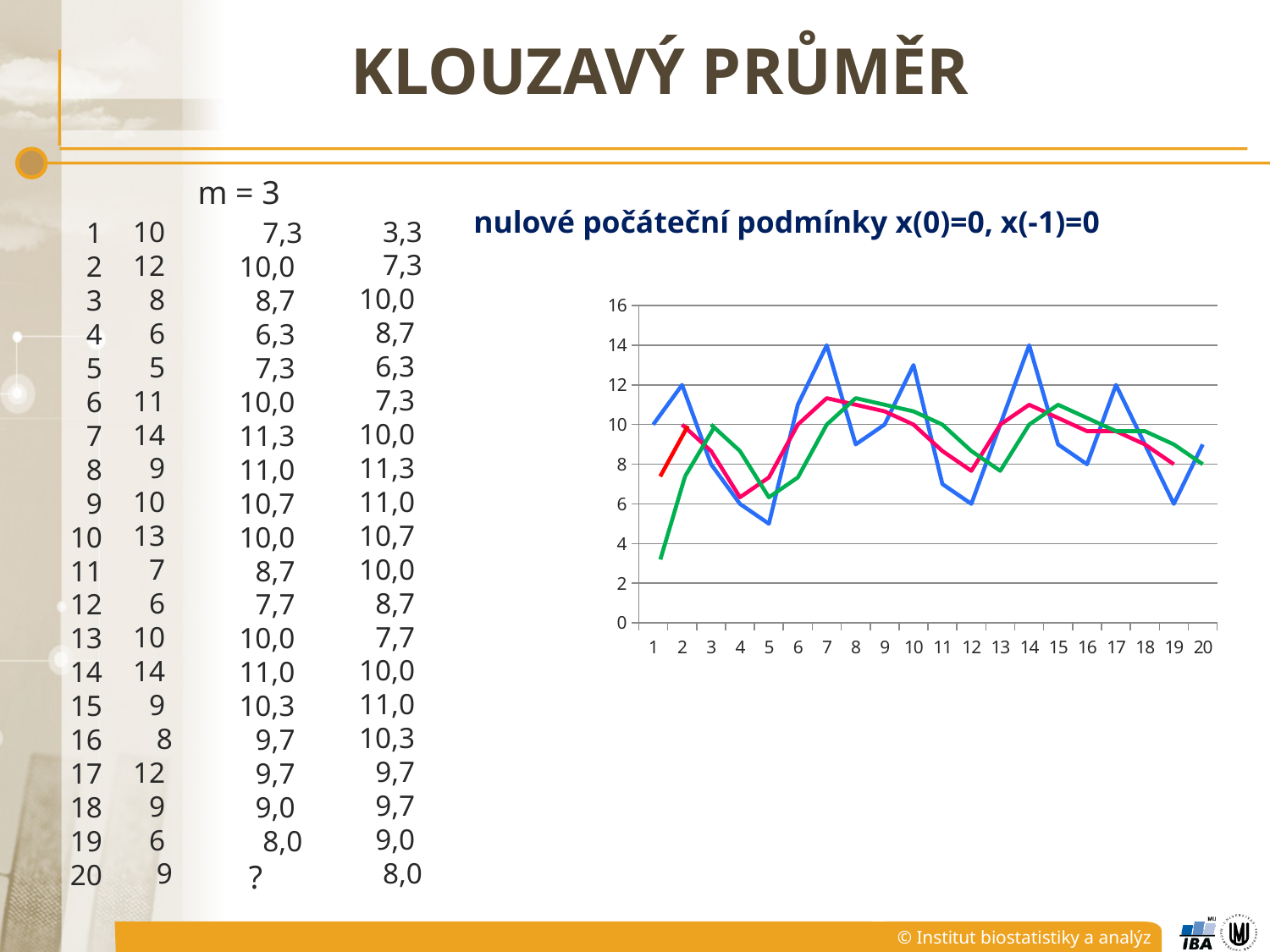
Between x = 5 and x = 7, does the blue line rise or fall? rise At which x value does the green line reach its lowest point? 1 How many lines are plotted on the chart? 3 What kind of chart is shown on the slide? line chart Is the value of the blue line at x = 7 greater or less than 12? greater Is the value of the green line at x = 1 greater or less than 4? less What is the highest value shown on the y axis of the chart? 16 At which x value does the blue line reach its lowest point? 5 How many points are labelled along the x axis of the chart? 20 At x = 14, which line has the larger value, the blue line or the red line? blue Is the value of the blue line at x = 5 greater or less than 6? less